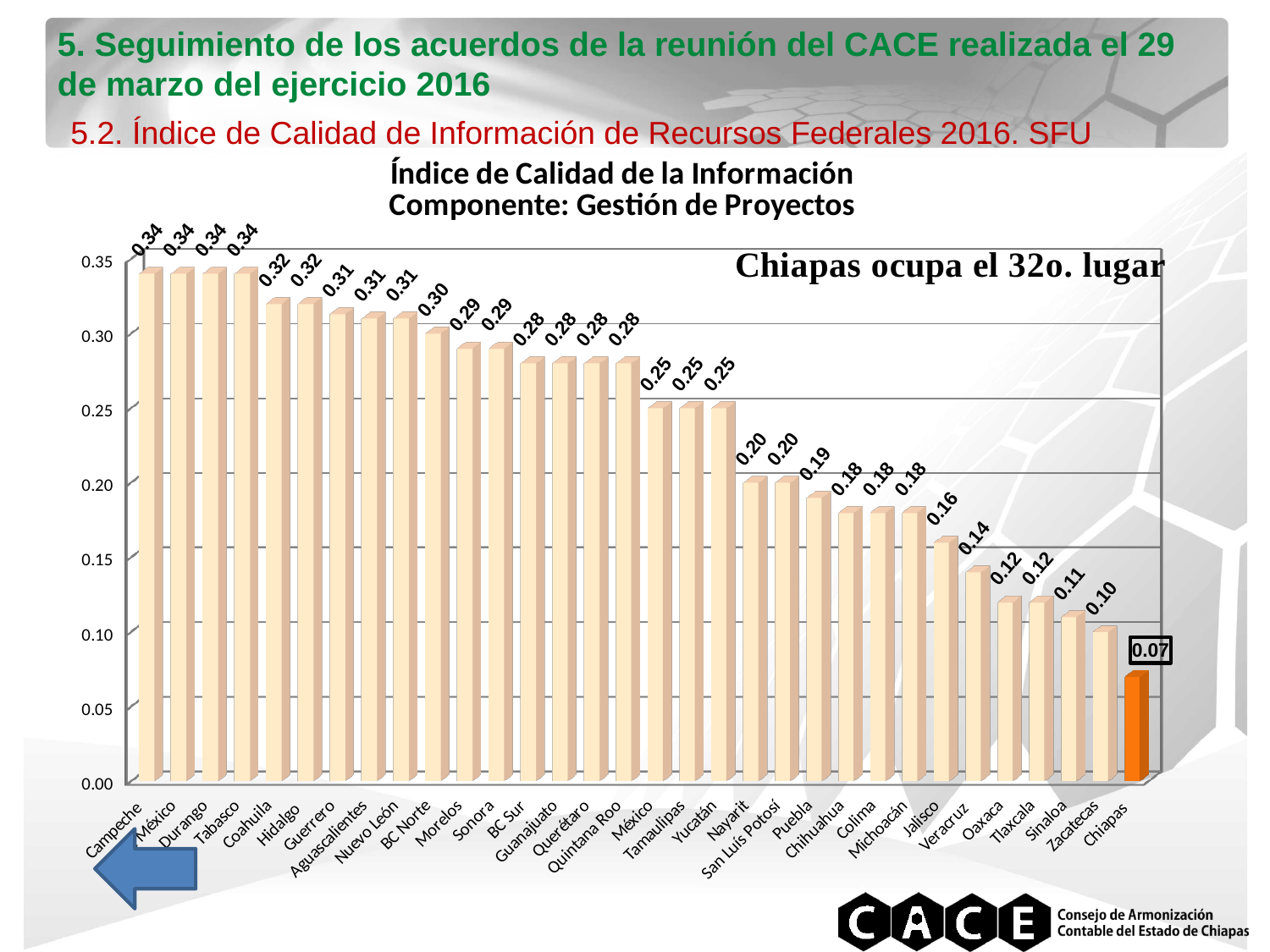
What is the value for Veracruz? 0.14 What is the value for Chiapas? 0.07 According to the text on the chart, what place does Chiapas occupy? 32o. lugar Do the values rise or fall from left to right along the x axis? fall Is the value for Sinaloa greater or less than 0.15? less Which state has the lowest value in the chart? Chiapas Which has a larger value, Nayarit or Veracruz? Nayarit What is the value for Puebla? 0.19 What is the difference between the values for Campeche and Chiapas? 0.27 How many states are shown in the chart? 32 What kind of chart is shown on the slide? bar chart What is the value for Jalisco? 0.16